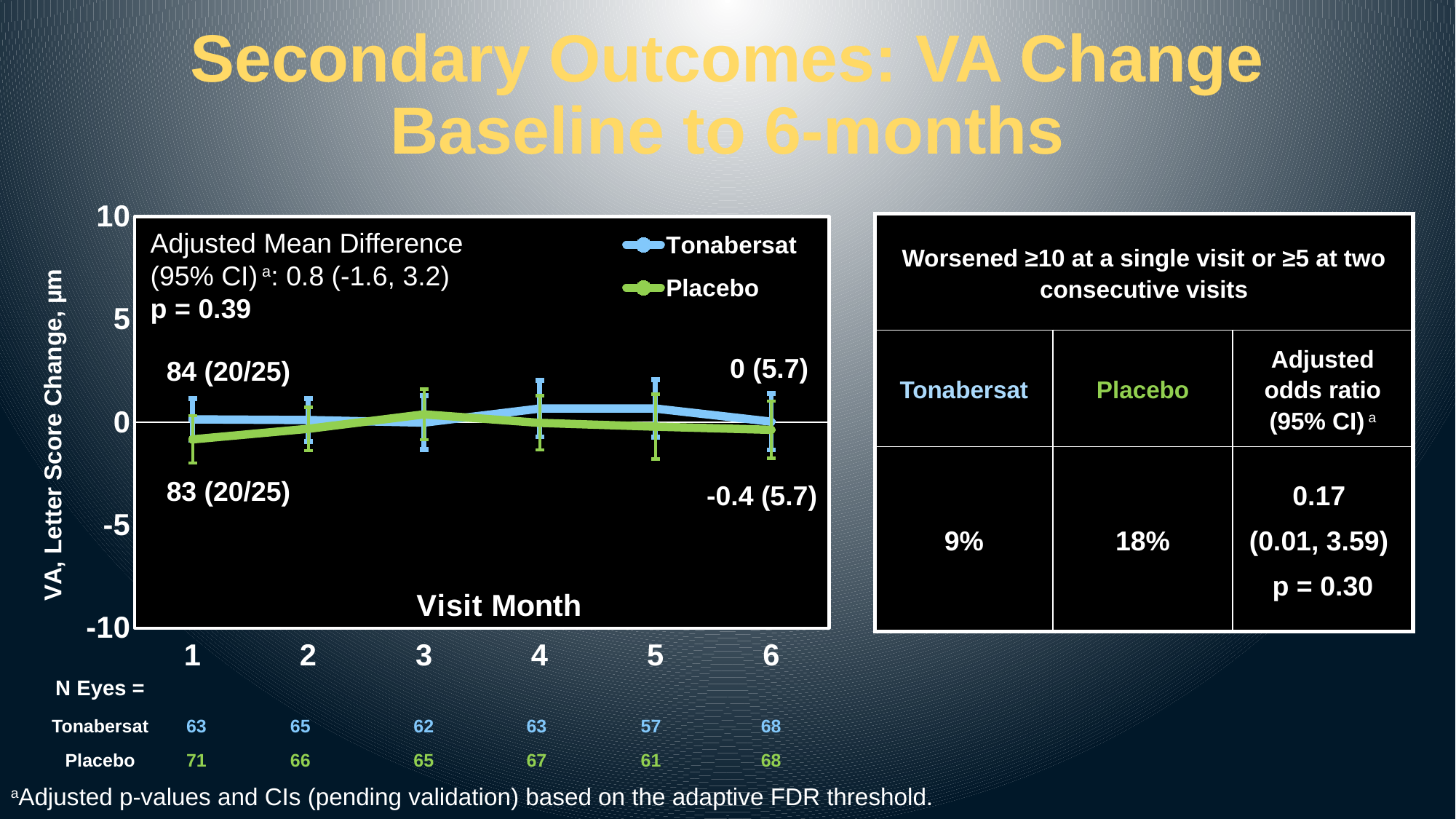
What is the labelled VA letter score change for Tonabersat at visit month 6? 0 (5.7) What is the difference between the labelled month-6 values for Tonabersat (0) and Placebo (-0.4)? 0.4 At visit month 6, which series has the higher labelled VA letter score change, Tonabersat or Placebo? Tonabersat Is the value for Tonabersat at visit month 4 greater or less than 5? less According to the N Eyes row below the chart, how many Tonabersat eyes were there at visit month 5? 57 Which two series are listed in the chart legend? Tonabersat and Placebo How many series does the chart legend list? 2 What is the x-axis title of the chart? Visit Month What is the adjusted mean difference (95% CI) printed on the chart? 0.8 (-1.6, 3.2) What kind of chart is shown on the slide? Line chart How many visit months are plotted along the x axis? 6 What is the labelled VA letter score change for Placebo at visit month 6? -0.4 (5.7)